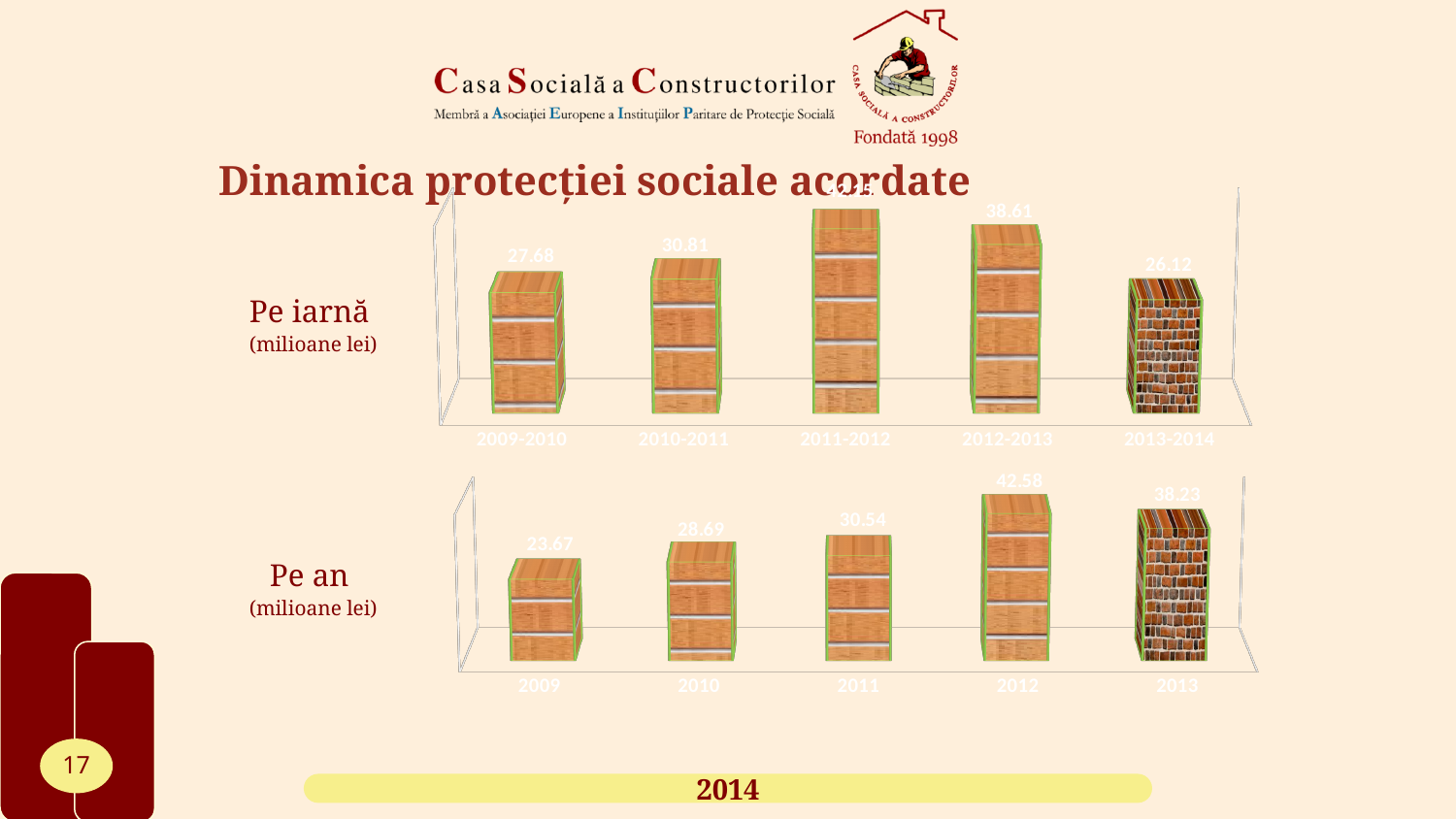
In the 'Pe iarnă' chart, what is the difference between the values for 2012-2013 and 2013-2014? 12.49 In the 'Pe an' chart, which year has the highest value? 2012 In the 'Pe an' chart, what is the value for 2009? 23.67 In the 'Pe an' chart, what is the difference between the values for 2010 and 2009? 5.02 What kind of chart is the 'Pe an' chart? Bar chart In the 'Pe iarnă' chart, which period has the highest value? 2011-2012 In the 'Pe an' chart, what is the value for 2012? 42.58 In the 'Pe iarnă' chart, which period has the lowest value? 2013-2014 In the 'Pe iarnă' chart, how many periods are shown? 5 In the 'Pe iarnă' chart, what is the value for 2009-2010? 27.68 In the 'Pe iarnă' chart, what is the value for 2012-2013? 38.61 In the 'Pe an' chart, which is larger, the value for 2011 or the value for 2013? 2013